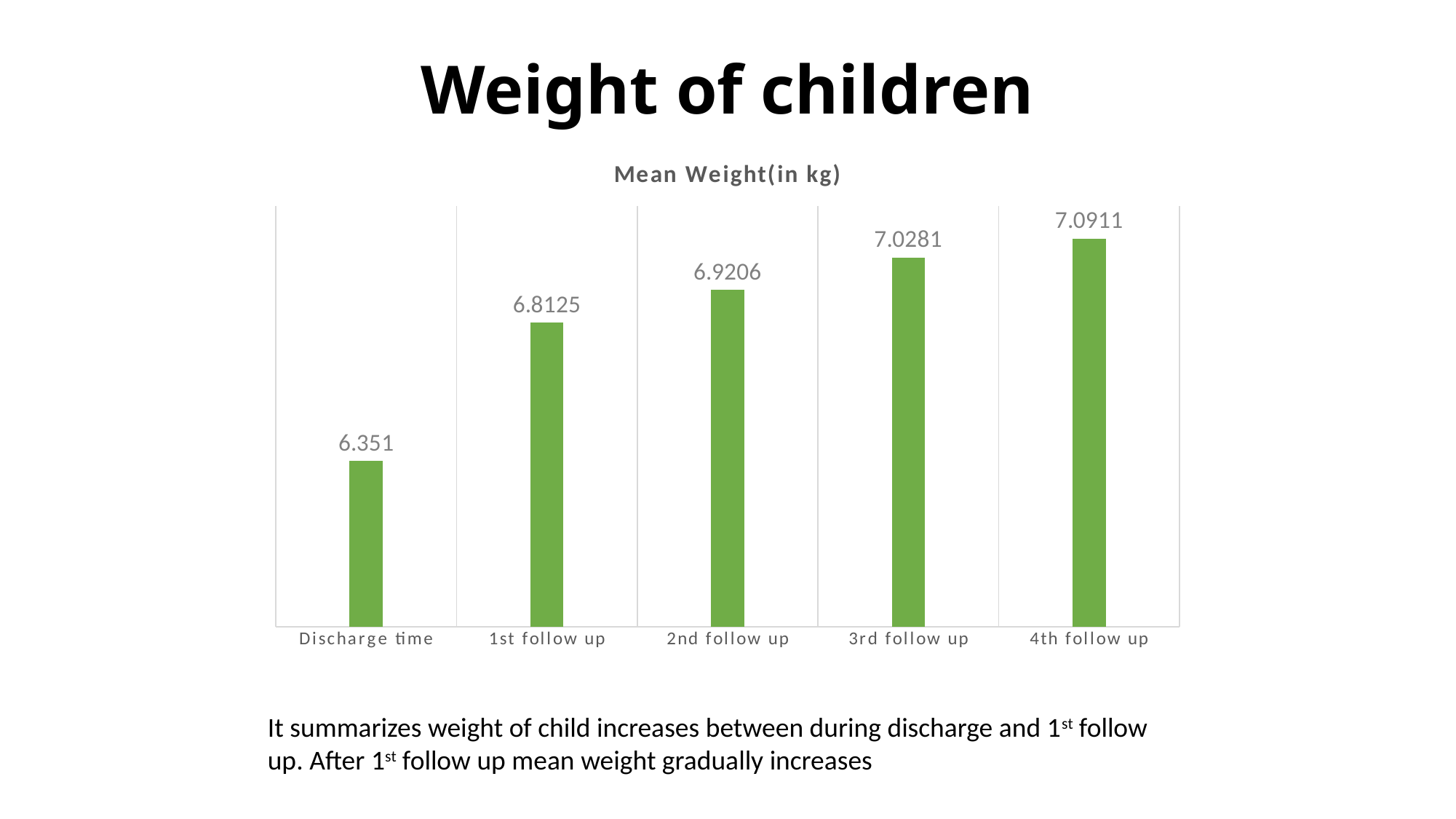
Which time point has the lowest mean weight? Discharge time What is the difference in mean weight between the 1st follow up and discharge time? 0.4615 Which time point has the highest mean weight? 4th follow up What is the mean weight at discharge time? 6.351 What is the mean weight at the 3rd follow up? 7.0281 What is the mean weight at the 4th follow up? 7.0911 What type of chart is shown on the slide? Bar chart Does the mean weight rise or fall from discharge time to the 4th follow up? Rise What is the mean weight at the 2nd follow up? 6.9206 Which has a higher mean weight, the 2nd follow up or the 3rd follow up? 3rd follow up How many time points are shown in the chart? 5 What is the mean weight at the 1st follow up? 6.8125